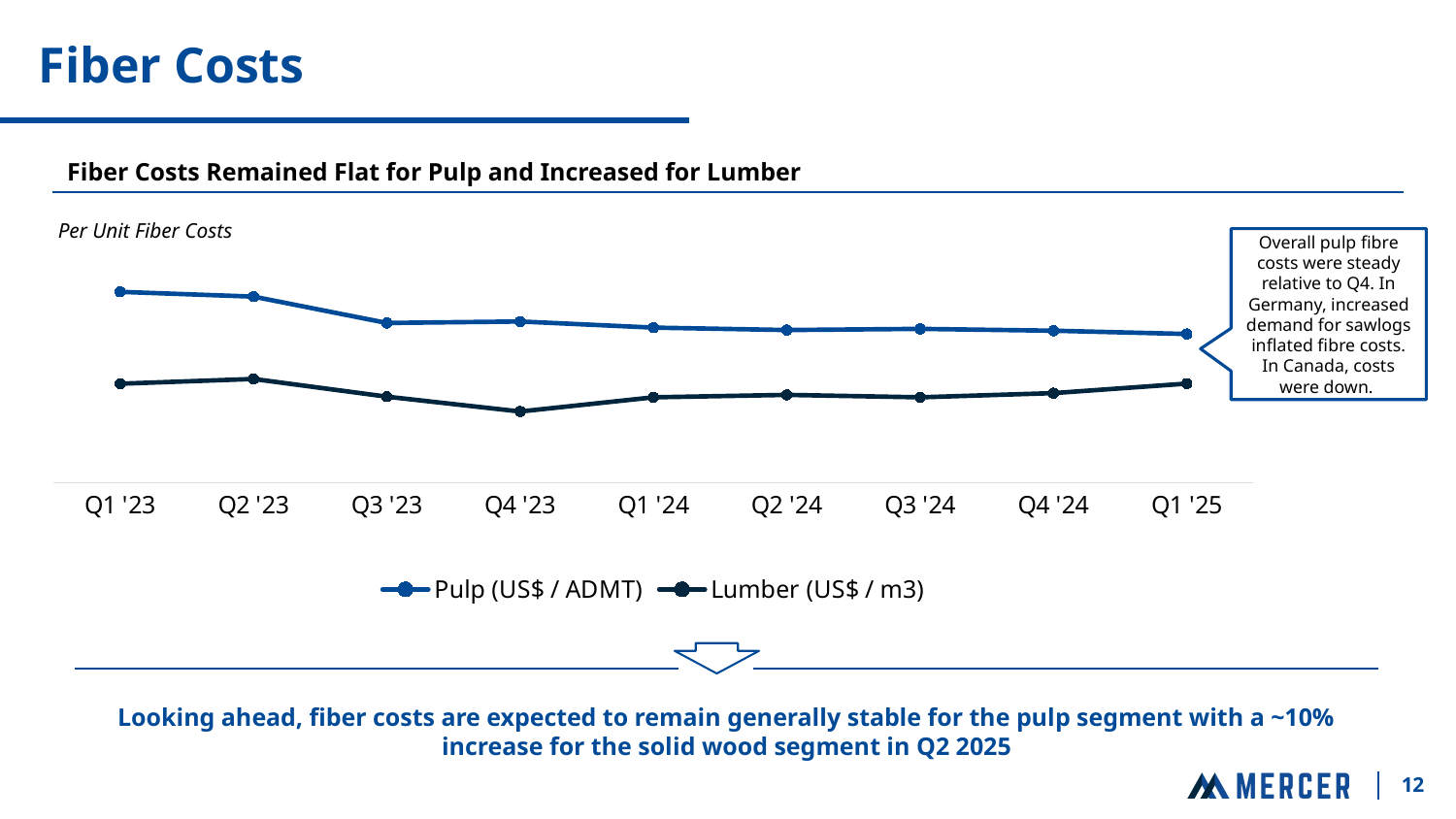
What unit is given in the legend for the Lumber series? US$ / m3 How many quarters are plotted along the x axis of the chart? 9 Does the Lumber (US$ / m3) series rise or fall from Q4 '23 to Q1 '25? Rise Which series is plotted as the upper line on the chart? Pulp (US$ / ADMT) Which quarter has the lowest value for the Lumber (US$ / m3) series? Q4 '23 How many series does the chart legend list? 2 Which quarter has the highest value for the Pulp (US$ / ADMT) series? Q1 '23 What is the title shown above the chart? Per Unit Fiber Costs Does the Pulp (US$ / ADMT) series rise or fall from Q1 '23 to Q1 '25? Fall Is the Lumber (US$ / m3) value higher in Q2 '23 or in Q4 '23? Q2 '23 What kind of chart is shown on the slide? Line chart Is the Pulp (US$ / ADMT) value higher in Q1 '23 or in Q1 '25? Q1 '23